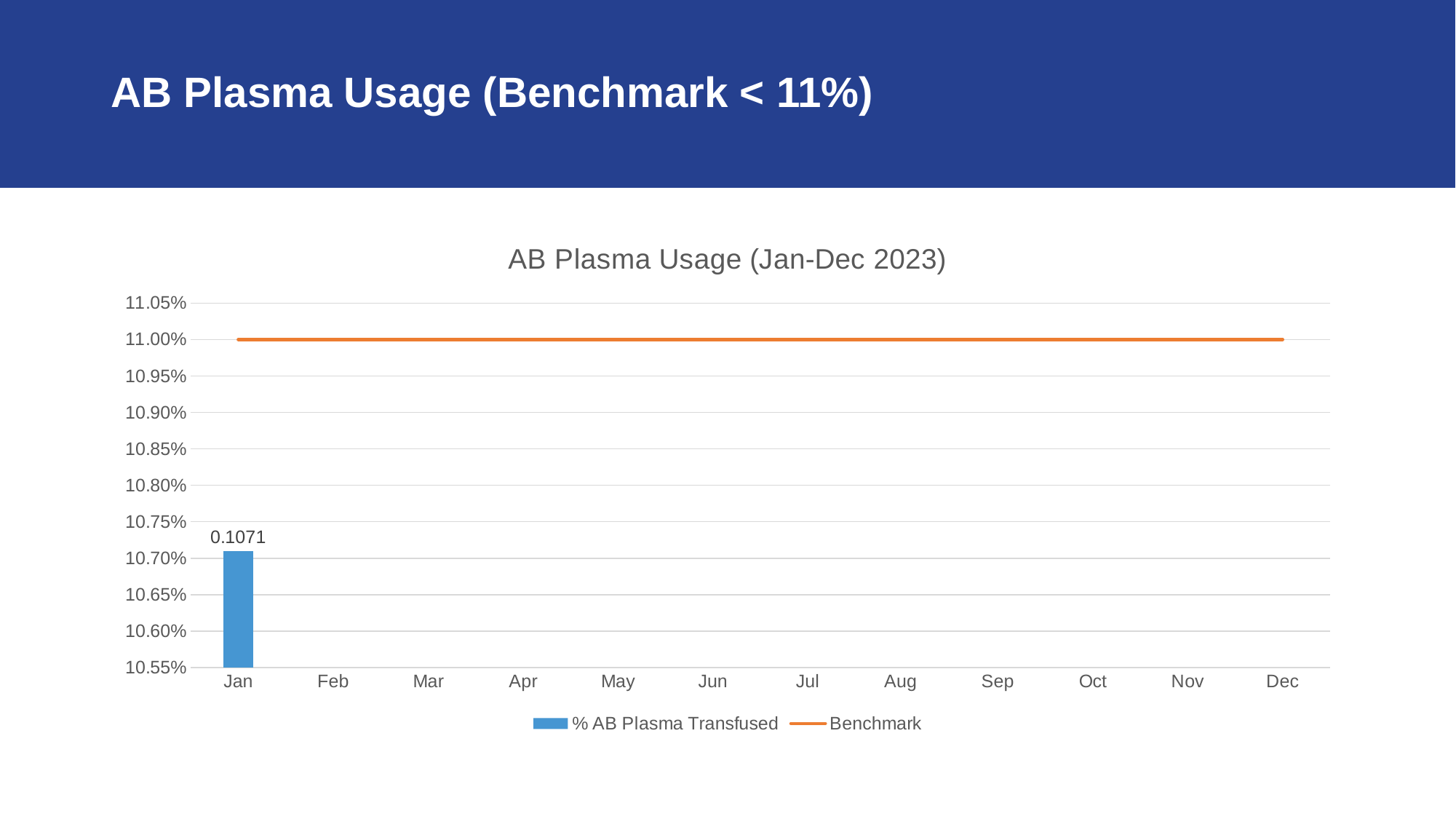
What kind of chart is this? bar chart with a line Which month is the only one with a % AB Plasma Transfused bar plotted? Jan Is the Jan value for % AB Plasma Transfused greater or less than 10.65%? greater Is the Jan value for % AB Plasma Transfused greater or less than 11.00%? less How many series does the legend list? 2 What is the title of the chart? AB Plasma Usage (Jan-Dec 2023) What is the data label shown on the Jan bar for % AB Plasma Transfused? 0.1071 At what value on the y axis does the Benchmark line sit? 11.00% Which is larger in Jan, the % AB Plasma Transfused bar or the Benchmark line? Benchmark How many months are shown on the x axis? 12 What colour is the Benchmark line? orange